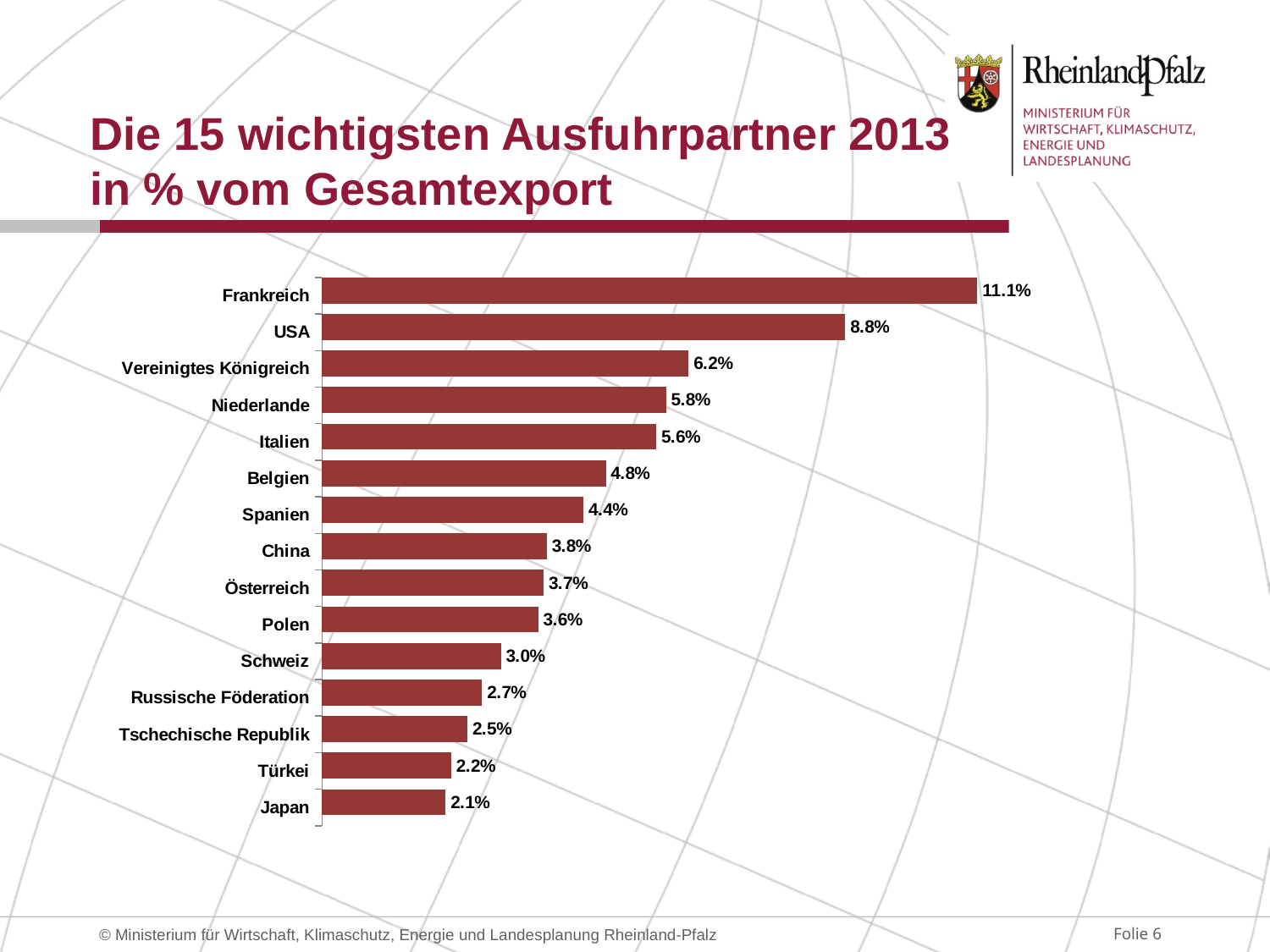
What is the title of the slide? Die 15 wichtigsten Ausfuhrpartner 2013 in % vom Gesamtexport What is the export share for Russische Föderation? 2.7% Which has a larger export share, Italien or Vereinigtes Königreich? Vereinigtes Königreich Which country has the lowest export share? Japan What is the difference between the export shares of Belgien and Spanien? 0.4% What is the export share for Frankreich? 11.1% What is the difference between the export shares of Frankreich and USA? 2.3% How many countries are shown in the chart? 15 Which country has the highest export share? Frankreich Which has a larger export share, Schweiz or Polen? Polen What is the export share for Niederlande? 5.8% What kind of chart is shown on the slide? Bar chart